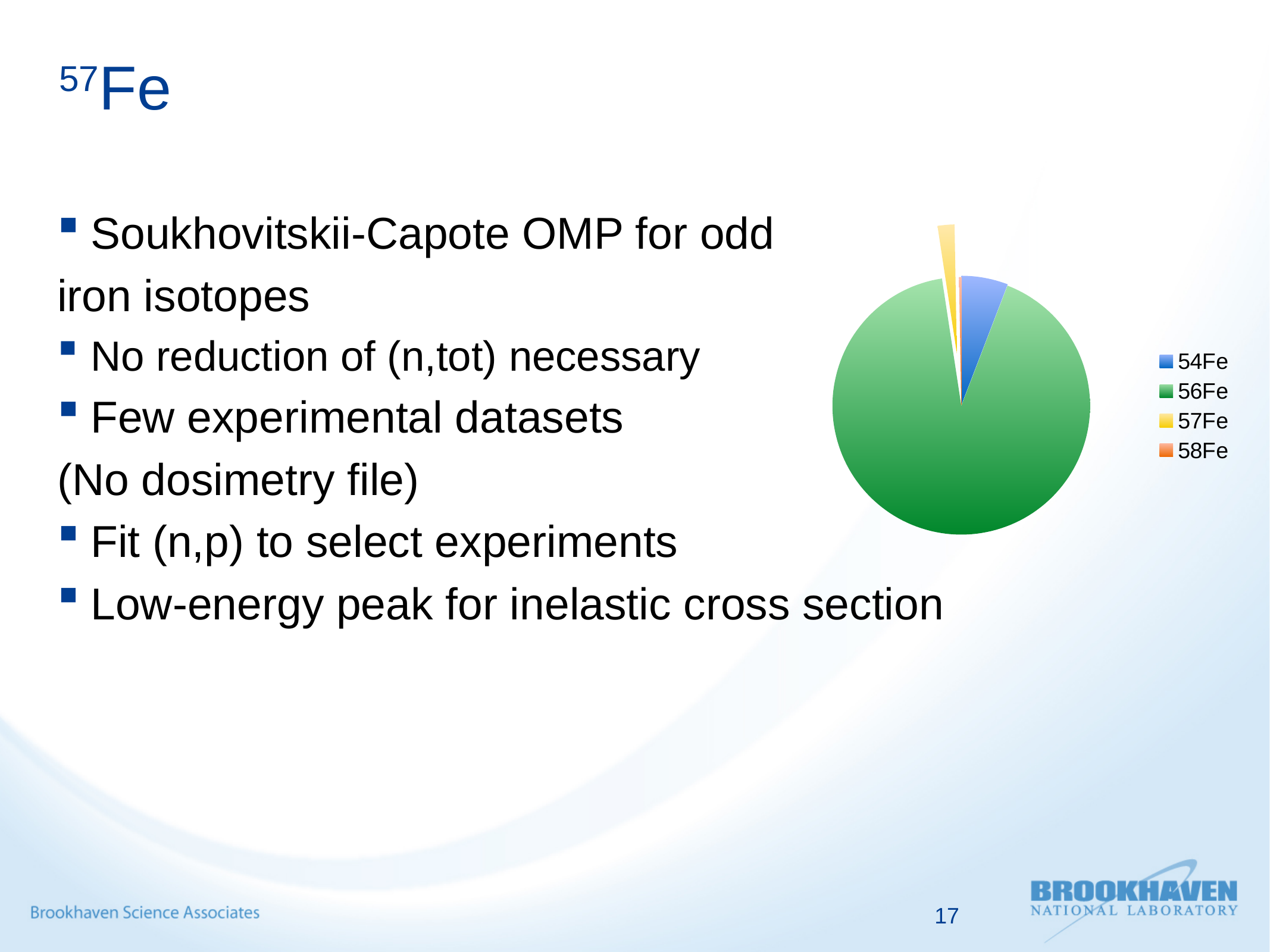
Which slice is larger in the pie chart, 57Fe or 58Fe? 57Fe Which isotope has the smallest slice in the pie chart? 58Fe Which slice of the pie chart is pulled out (exploded) from the rest of the pie? 57Fe Which slice is larger in the pie chart, 54Fe or 56Fe? 56Fe What colour represents 56Fe in the pie chart? green How many categories does the pie chart's legend list? 4 Which isotope has the largest slice in the pie chart? 56Fe Which slice is larger in the pie chart, 54Fe or 57Fe? 54Fe What kind of chart is shown on the slide? pie chart